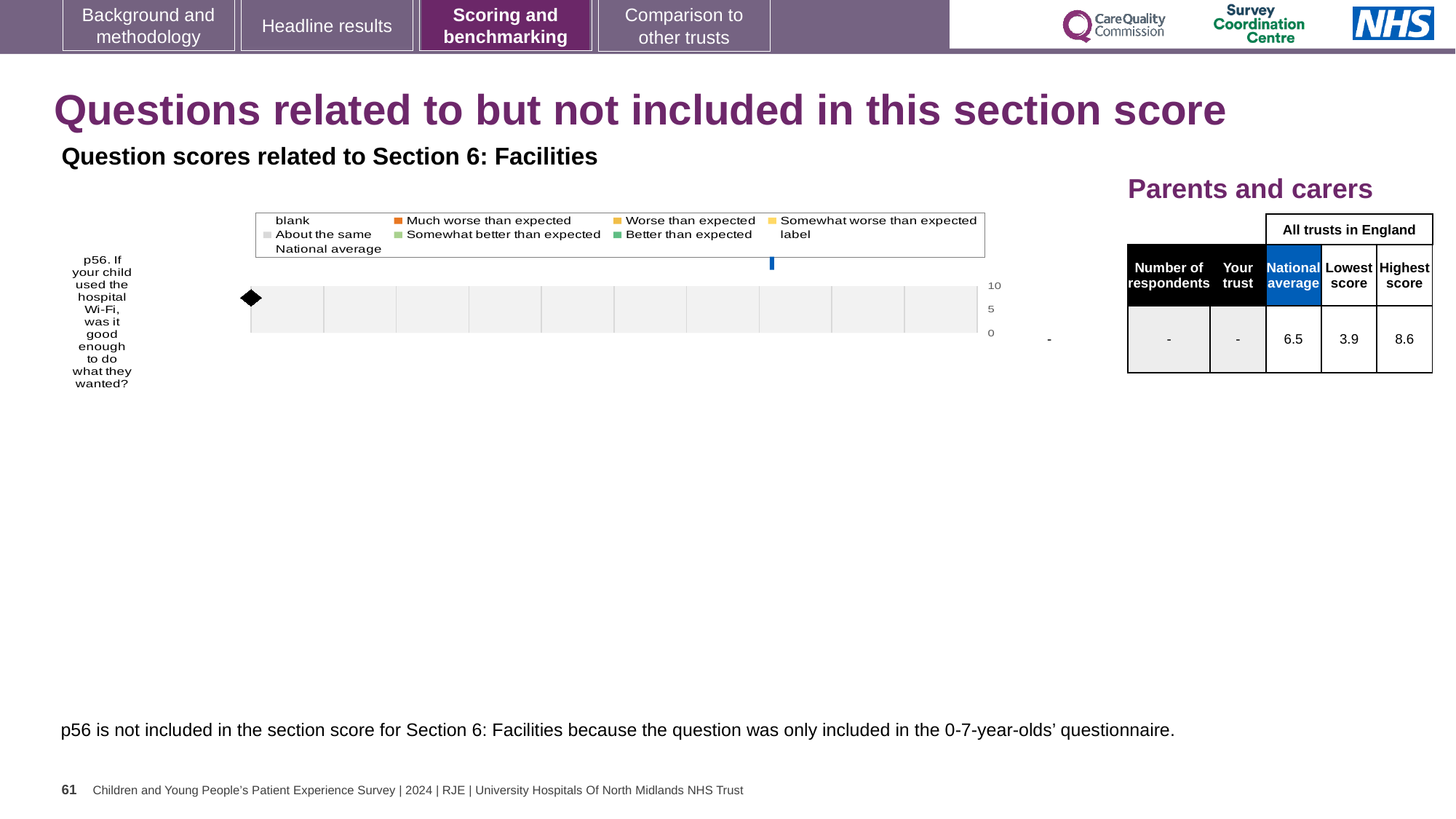
What is the difference between the highest score and the lowest score for p56? 4.7 What kind of chart is used to show the question score for p56? bar chart What is the lowest score among all trusts in England for p56? 3.9 What is the 'Your trust' score shown for p56? - How many questions (categories) are plotted on the chart? 1 What is the highest score among all trusts in England for p56? 8.6 What is the maximum value shown on the chart's score axis? 10 Which respondent group does the chart relate to, according to the heading above the table? Parents and carers What is the number of respondents shown for p56? - Is the national average score for p56 greater or less than 5? greater What is the national average score for p56? 6.5 Which is larger for p56: the national average or the highest score? Highest score